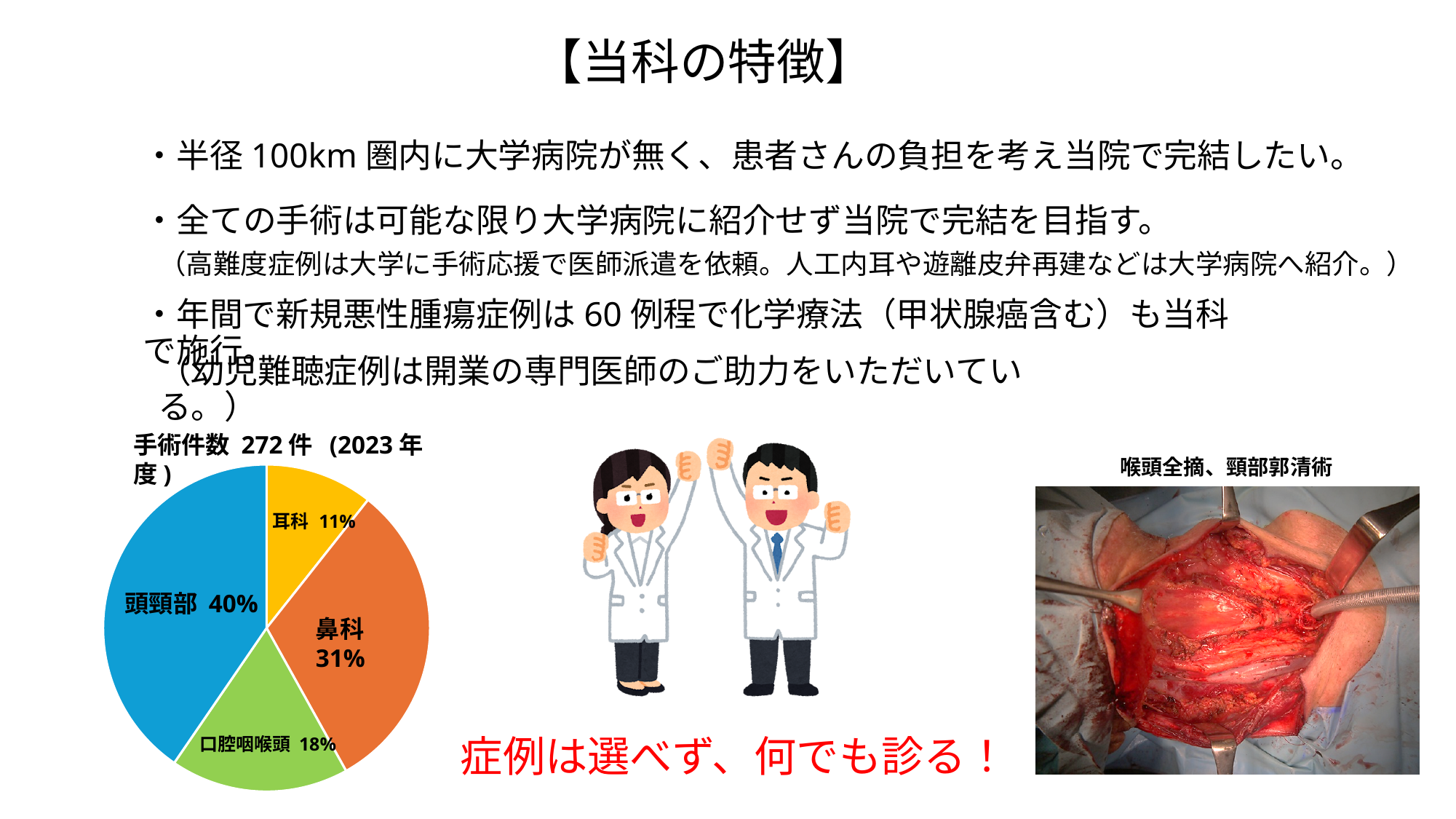
What is the total number of surgeries stated in the pie chart title? 272件 What type of chart is shown on the slide? pie chart What percentage of surgeries does 耳科 account for in the pie chart? 11% How many categories are shown in the pie chart? 4 Which has a larger share in the pie chart, 口腔咽喉頭 or 耳科? 口腔咽喉頭 Which category has the smallest share in the pie chart? 耳科 What percentage of surgeries does 頭頸部 account for in the pie chart? 40% What percentage of surgeries does 鼻科 account for in the pie chart? 31% What is the difference in percentage points between 頭頸部 and 鼻科 in the pie chart? 9 What is the title of the pie chart? 手術件数 272件（2023年度） Which category has the largest share in the pie chart? 頭頸部 What percentage of surgeries does 口腔咽喉頭 account for in the pie chart? 18%